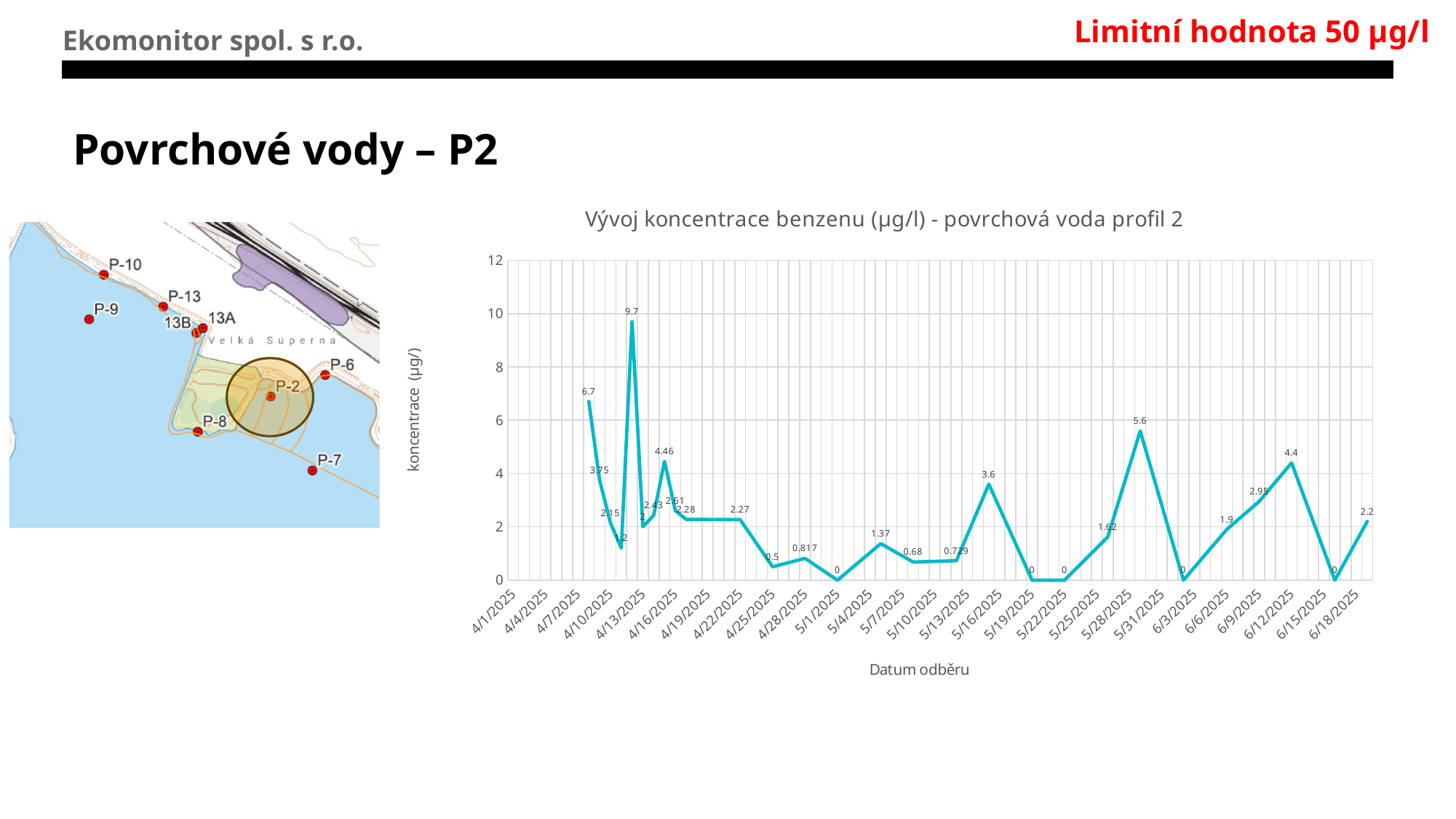
Is the highest value on the chart greater or less than 8? greater What is the difference between the peaks labelled 5.6 and 4.4? 1.2 What is the title of the chart? Vývoj koncentrace benzenu (µg/l) - povrchová voda profil 2 What type of chart is shown on the slide? line chart What is the highest benzene concentration value plotted on the chart? 9.7 What is the difference between the highest value (9.7) and the last value (2.2)? 7.5 Which is larger, the peak labelled 5.6 or the peak labelled 4.46? 5.6 What is the value of the first data point on the chart? 6.7 What is the label of the x axis of the chart? Datum odběru What is the value of the last data point on the chart (around 6/18/2025)? 2.2 Comparing the first data point to the last data point, did the concentration rise or fall? fall What is the lowest benzene concentration value plotted on the chart? 0